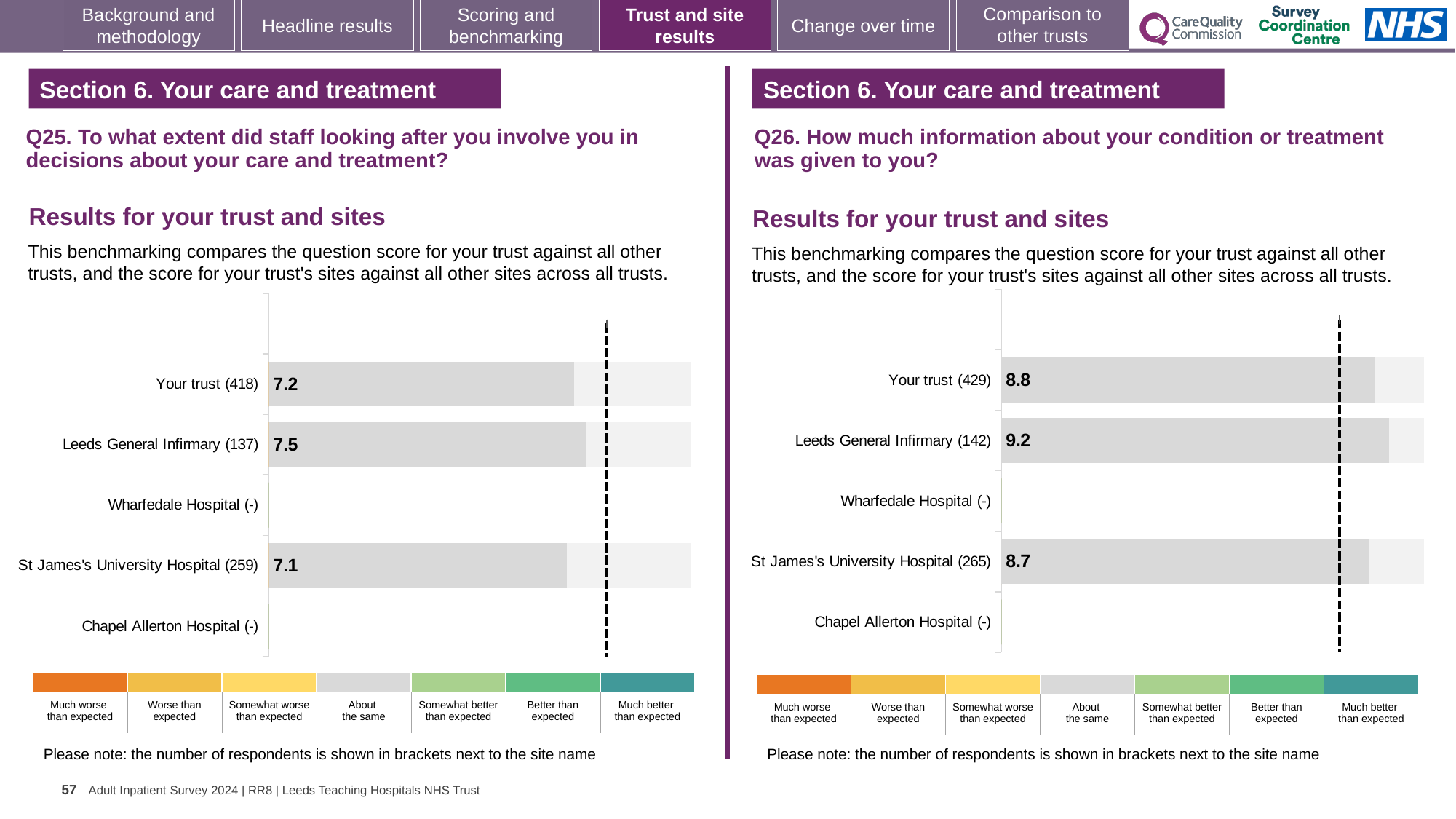
On the Q25 chart (left), which site with a score shown has the highest score? Leeds General Infirmary On the Q25 chart (left), what is the score for Your trust? 7.2 On the Q26 chart (right), which site with a score shown has the lowest score? St James's University Hospital On the Q25 chart (left), what is the difference between the scores for Leeds General Infirmary and St James's University Hospital? 0.4 On the Q26 chart (right), what is the difference between the scores for Leeds General Infirmary and Your trust? 0.4 On the Q25 chart (left), what is the score for St James's University Hospital? 7.1 On the Q26 chart (right), what is the score for Your trust? 8.8 On the Q26 chart (right), what is the score for Leeds General Infirmary? 9.2 On the Q26 chart (right), how many respondents are shown in brackets for Your trust? 429 On the Q26 chart (right), what is the score for St James's University Hospital? 8.7 On the Q25 chart (left), what is the score for Leeds General Infirmary? 7.5 What kind of chart is used on the Q25 chart (left)? Bar chart